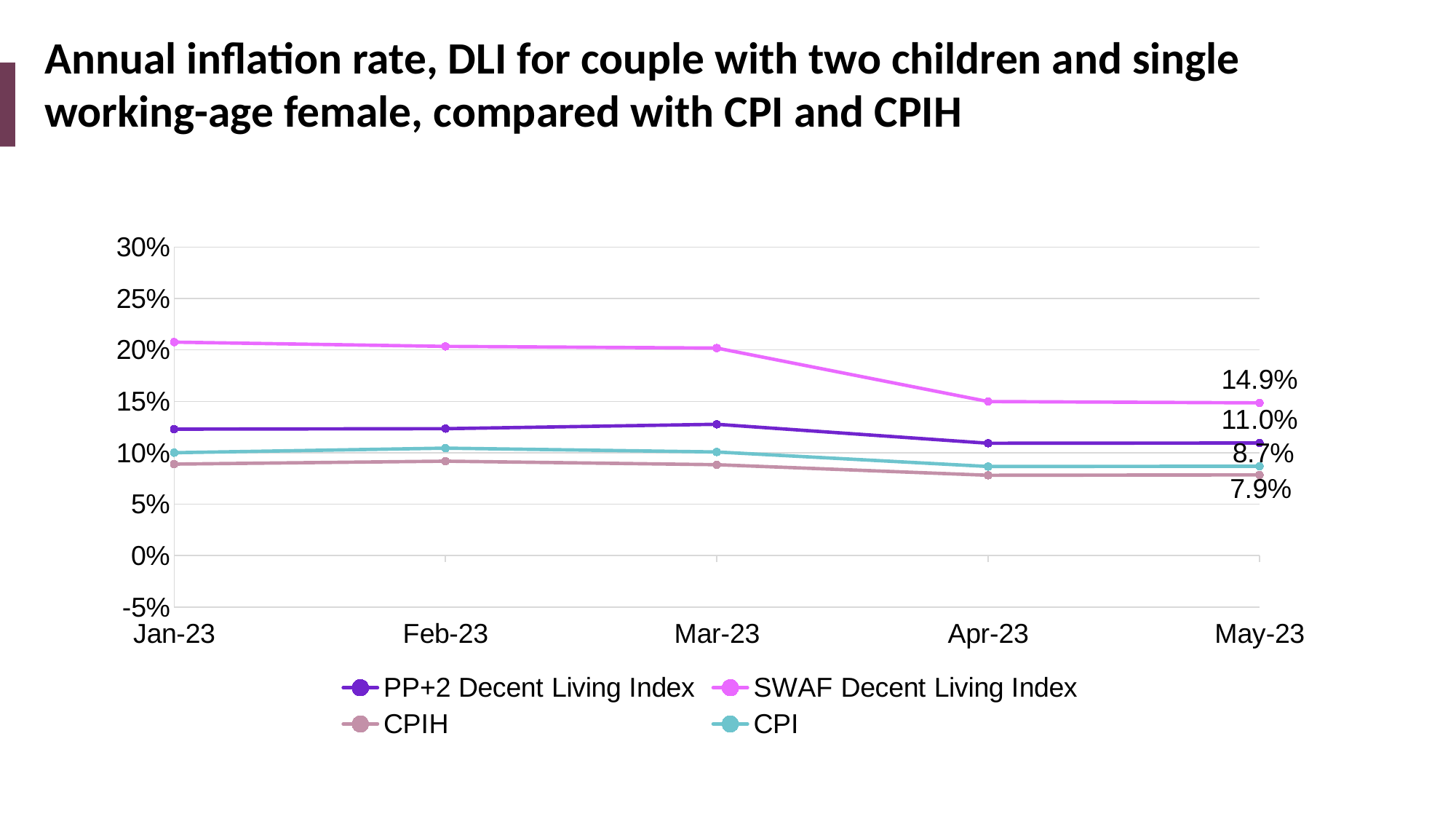
Is the SWAF Decent Living Index value in Jan-23 greater or less than 20%? greater Which series has the lowest value in May-23? CPIH How many series does the legend list? 4 What is the CPIH value in May-23? 7.9% What is the value of the PP+2 Decent Living Index in May-23? 11.0% Does the SWAF Decent Living Index rise or fall from Jan-23 to May-23? fall What is the value of the SWAF Decent Living Index in May-23? 14.9% What type of chart is shown on the slide? line chart What is the difference between the SWAF Decent Living Index and the PP+2 Decent Living Index in May-23? 3.9% How many months are plotted along the x axis? 5 What is the CPI value in May-23? 8.7% Which series has the highest value in May-23? SWAF Decent Living Index